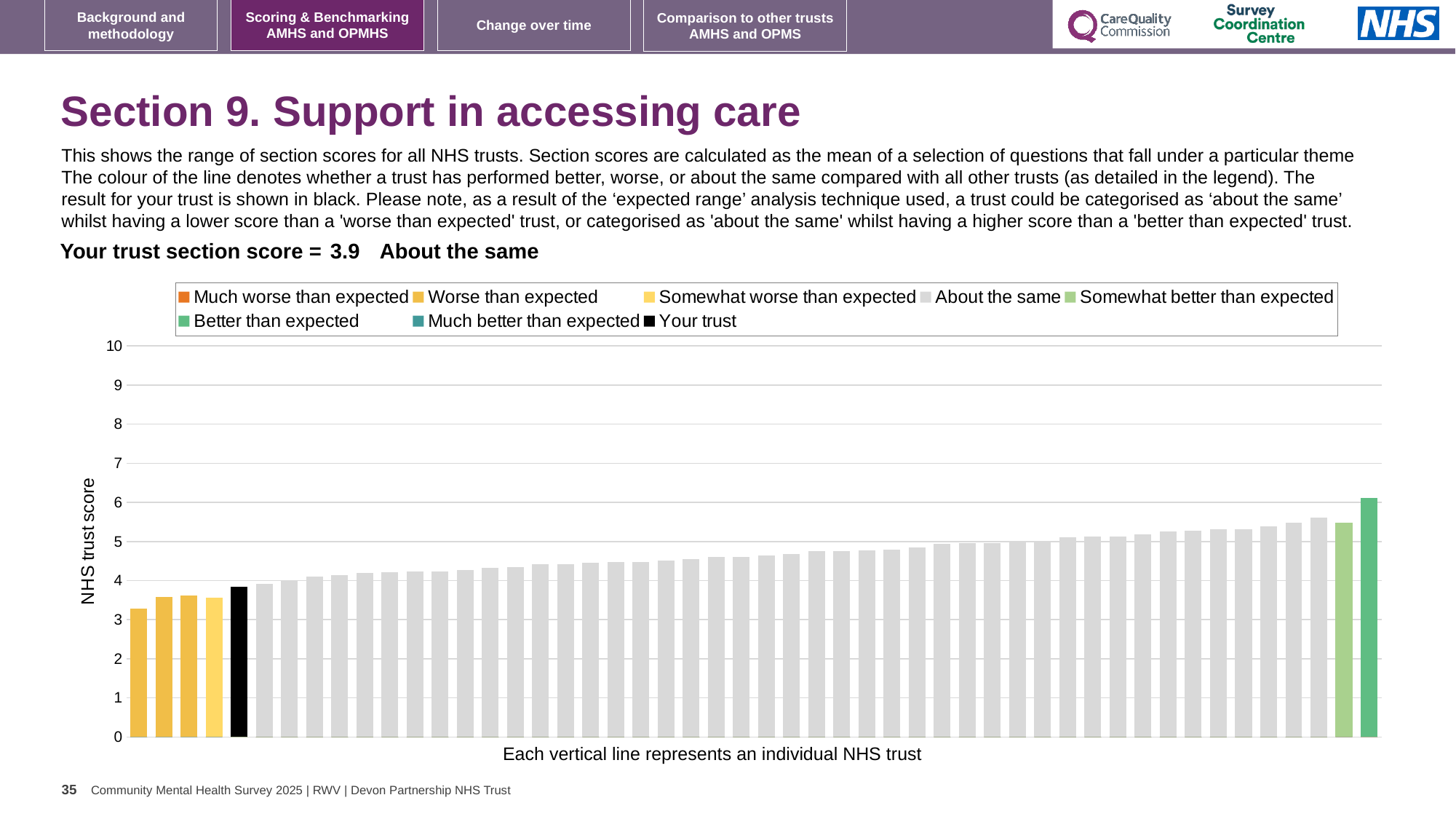
What kind of chart is shown on the slide? bar chart How many entries does the chart legend list? 8 Is the value of the shortest bar greater or less than 3? greater How many bars are coloured green (better than expected categories)? 2 What is the label on the vertical axis of the chart? NHS trust score Which performance category is your trust placed in for this section? About the same Do the bar values rise or fall from left to right along the x axis? rise Is the black bar for your trust higher or lower than the rightmost bar? lower Is the value of the tallest bar greater or less than 5? greater How many bars are coloured yellow (worse than expected)? 4 What is the section score for your trust? 3.9 Is the value for your trust (the black bar) greater or less than 4? less